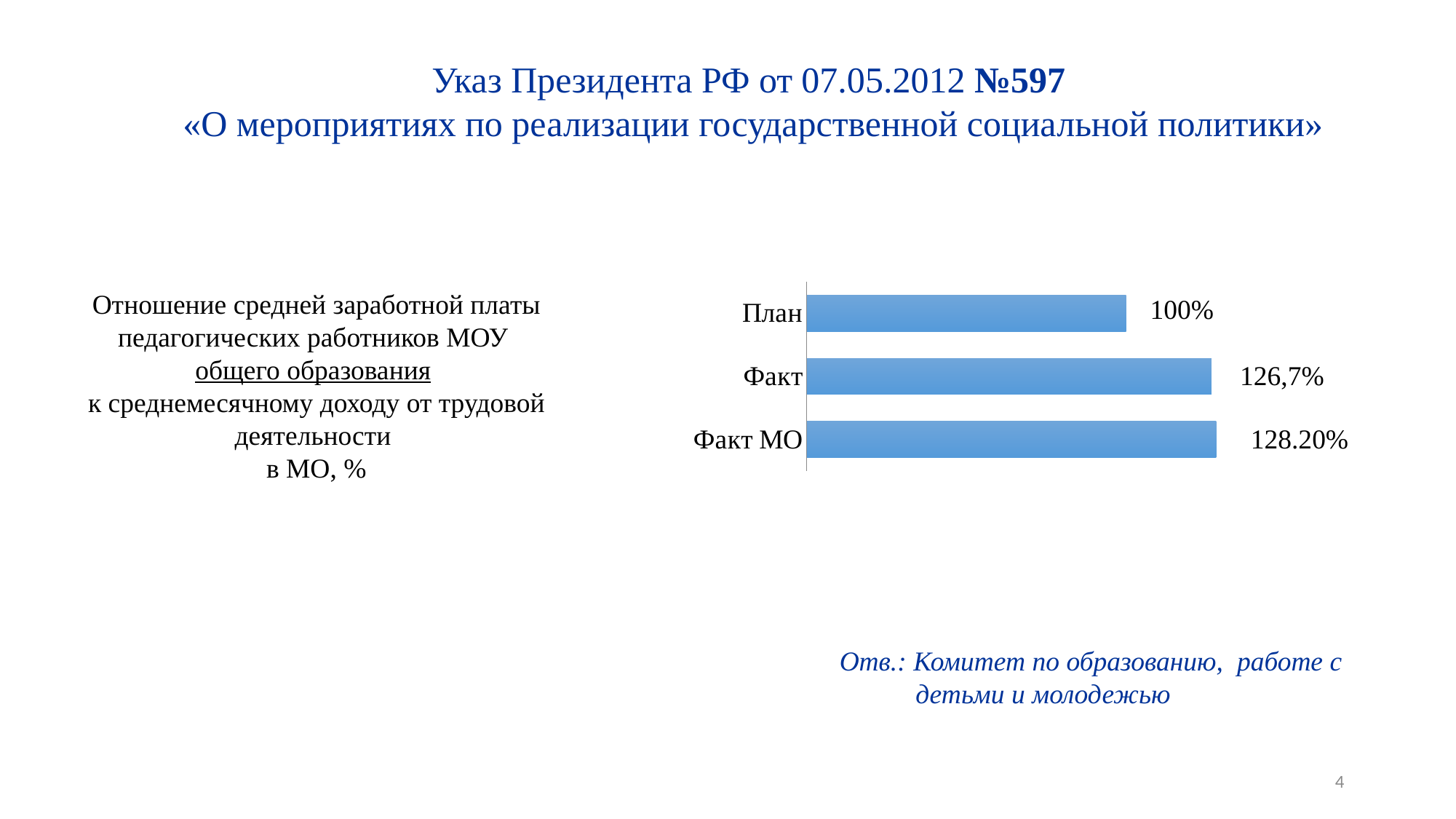
By how many percentage points does Факт exceed План? 26,7 What is the value for Факт МО? 128.20% Which is larger, the value for Факт МО or the value for Факт? Факт МО Which category has the highest value? Факт МО What is the value for Факт? 126,7% Which is larger, the value for Факт or the value for План? Факт What kind of chart is shown on the slide? bar chart By how many percentage points does Факт МО exceed План? 28.20 What colour are the bars in the chart? blue How many categories are shown in the chart? 3 Which category has the lowest value? План What is the value for План? 100%